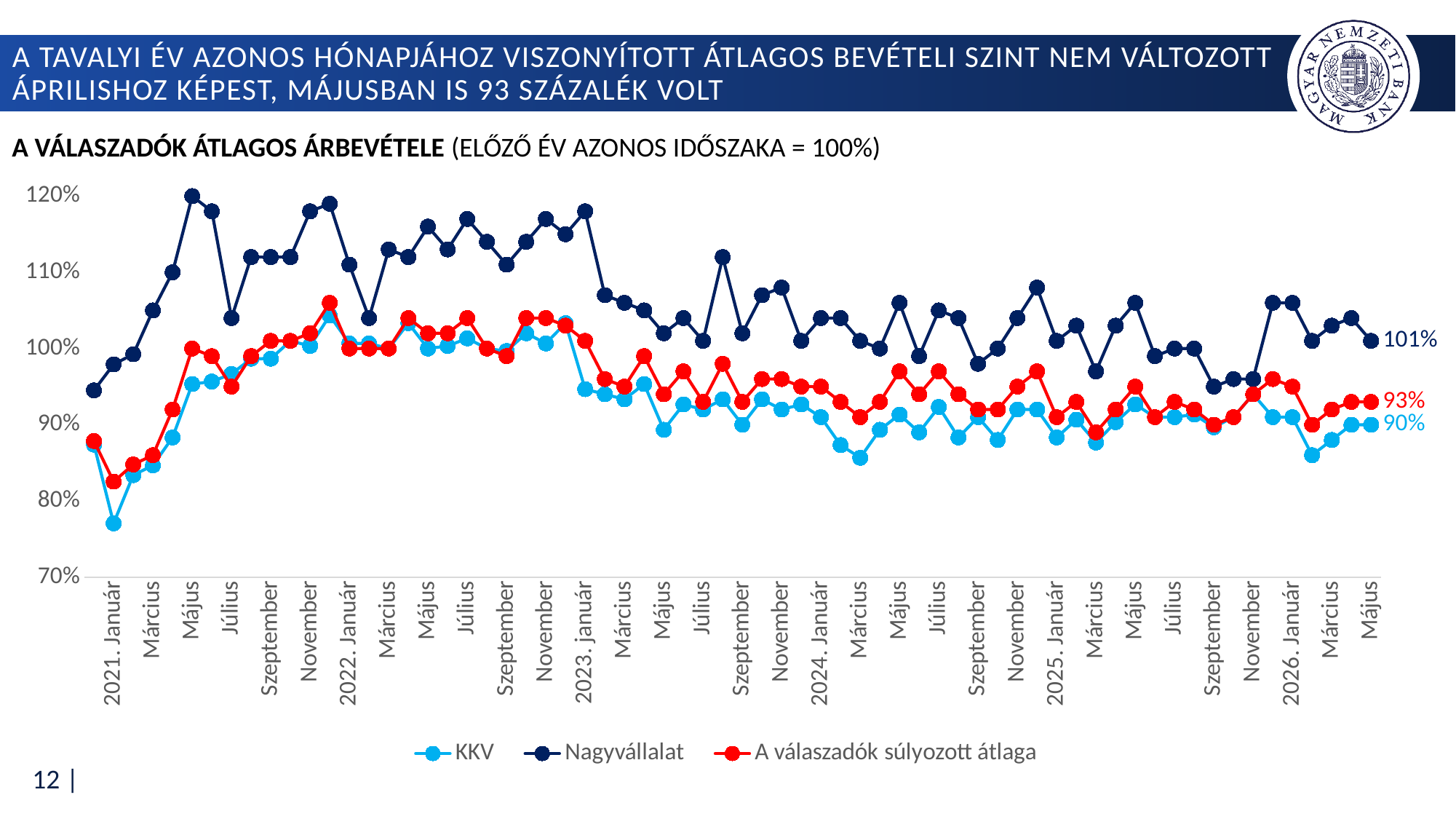
What is the value of the Nagyvállalat series at the last point (2026 Május)? 101% What is the value of 'A válaszadók súlyozott átlaga' at the last point (2026 Május)? 93% At 2026 Május, what is the difference between the Nagyvállalat value and the KKV value? 11 percentage points Does the Nagyvállalat series rise or fall from 2021. Január to 2021 Május? rise Is the Nagyvállalat value for 2021 Május greater or less than 110%? greater What kind of chart is shown on the slide? line chart What is the value of the KKV series at the last point (2026 Május)? 90% How many series does the legend list? 3 Is the KKV value for 2021. Január greater or less than 80%? less Which series has the highest value at 2026 Május? Nagyvállalat What are the three series names listed in the legend? KKV, Nagyvállalat, A válaszadók súlyozott átlaga At 2026 Május, which is higher: the KKV value or the Nagyvállalat value? Nagyvállalat